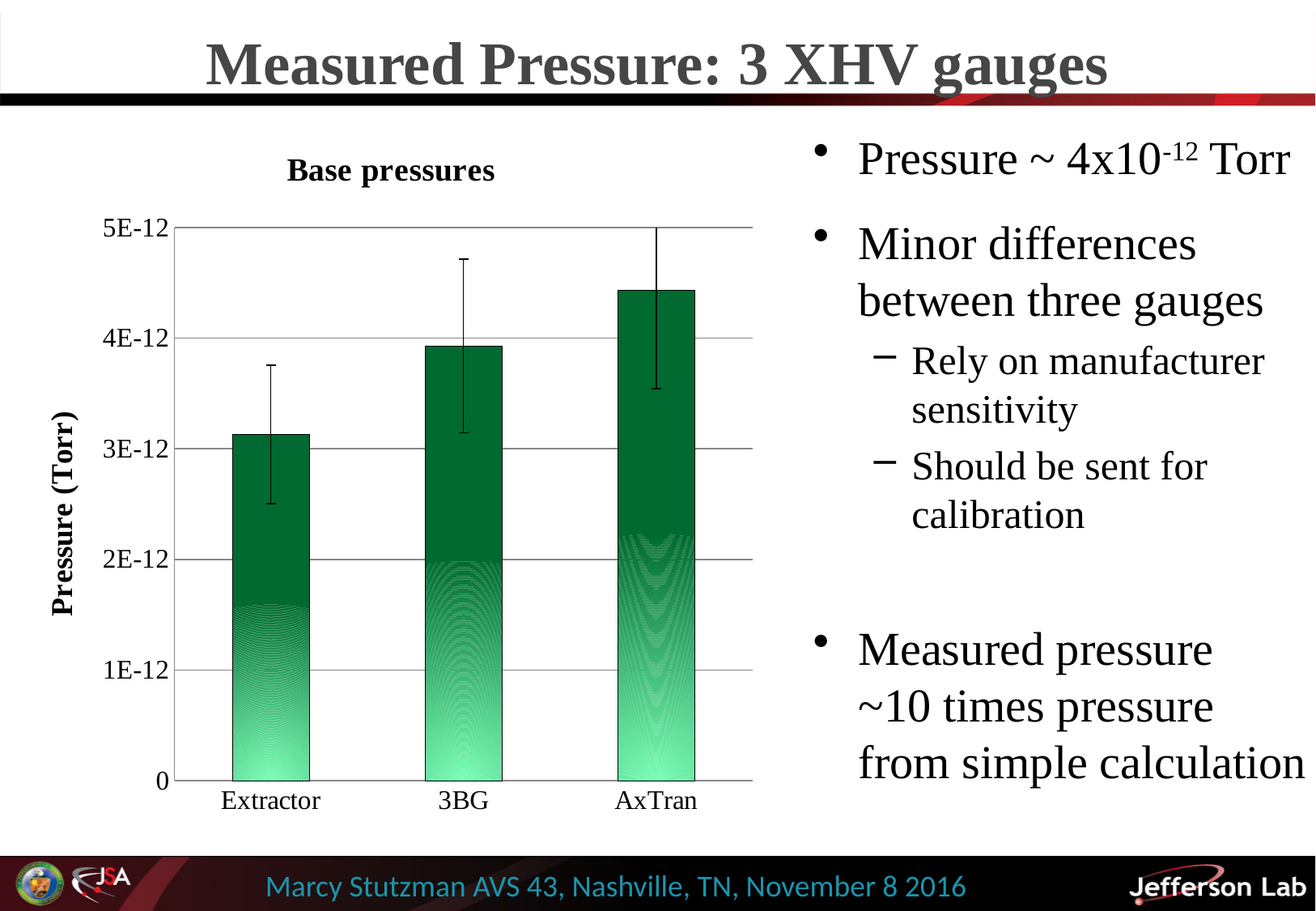
What is the title of the chart? Base pressures Is the base pressure for Extractor greater or less than 4E-12? less Which gauge has the lowest base pressure in the chart? Extractor Which has the larger base pressure, 3BG or AxTran? AxTran What is the label of the vertical axis of the chart? Pressure (Torr) How many gauges (categories) are plotted in the Base pressures chart? 3 Which has the larger base pressure, Extractor or 3BG? 3BG Is the base pressure for 3BG greater or less than 3E-12? greater Which gauge has the highest base pressure in the chart? AxTran What kind of chart is shown on the slide? bar chart Do the bar values rise or fall from Extractor to AxTran along the x axis? rise Is the base pressure for AxTran greater or less than 4E-12? greater